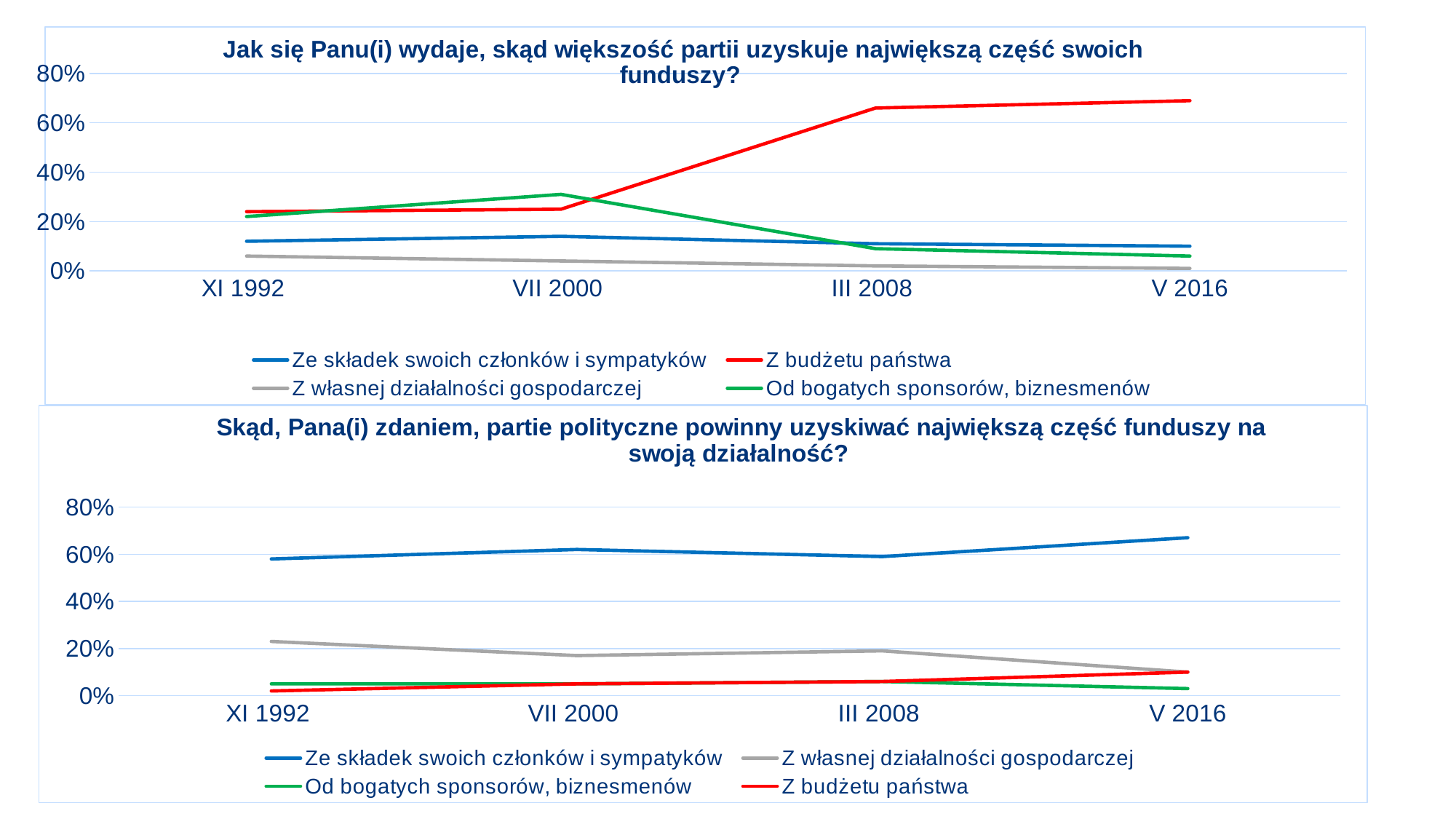
In the top chart, which series has the highest value at V 2016? Z budżetu państwa In the bottom chart, which is larger at XI 1992: 'Z własnej działalności gospodarczej' or 'Od bogatych sponsorów, biznesmenów'? Z własnej działalności gospodarczej In the top chart, which series has the lowest value at V 2016? Z własnej działalności gospodarczej In the bottom chart, does the 'Z budżetu państwa' line rise or fall from XI 1992 to V 2016? rise In the top chart, how many time points are shown on the x axis? 4 In the bottom chart, what colour is the line for 'Z budżetu państwa'? red In the top chart, does the 'Od bogatych sponsorów, biznesmenów' line rise or fall from VII 2000 to V 2016? fall In the top chart, how many series does the legend list? 4 In the bottom chart, is the value for 'Ze składek swoich członków i sympatyków' at V 2016 greater or less than 60%? greater In the top chart, is the value for 'Z budżetu państwa' at V 2016 greater or less than 60%? greater In the bottom chart, 'Skąd, Pana(i) zdaniem, partie polityczne powinny uzyskiwać największą część funduszy na swoją działalność?', which series has the highest value at XI 1992? Ze składek swoich członków i sympatyków What kind of chart is the top chart, 'Jak się Panu(i) wydaje, skąd większość partii uzyskuje największą część swoich funduszy?'? line chart